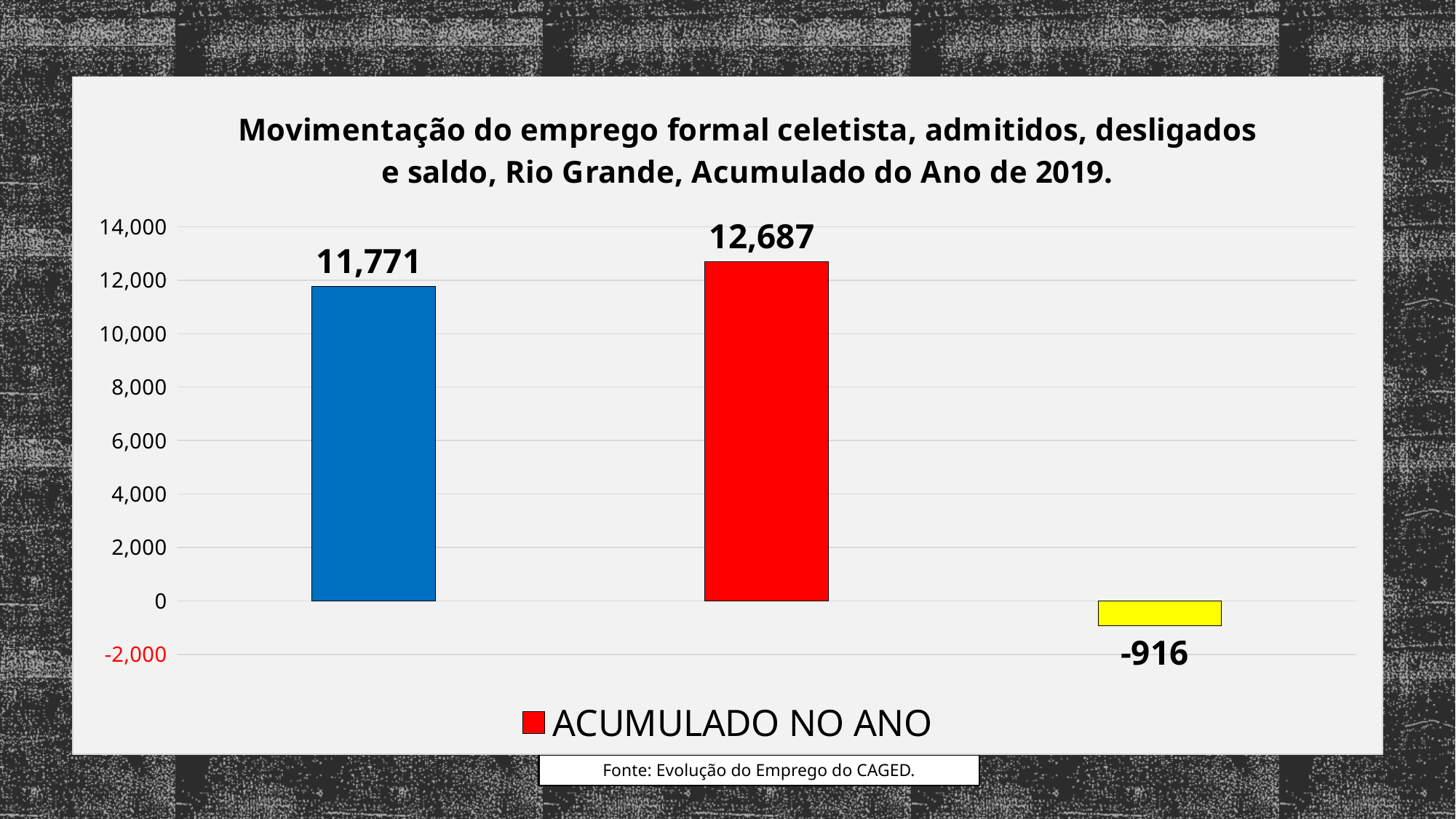
What value is shown on the red bar? 12,687 What is the legend entry shown below the chart? ACUMULADO NO ANO Is the value of the blue bar greater or less than 12,000? less What value is shown on the blue bar? 11,771 What kind of chart is shown on the slide? bar chart What is the difference between the red bar's value and the blue bar's value? 916 Which bar has the highest value: the blue, red or yellow one? red How many series does the legend list? 1 Which is larger, the value of the blue bar or the value of the red bar? red bar How many bars are plotted in the chart? 3 What value is shown on the yellow bar? -916 Which bar has the lowest value: the blue, red or yellow one? yellow